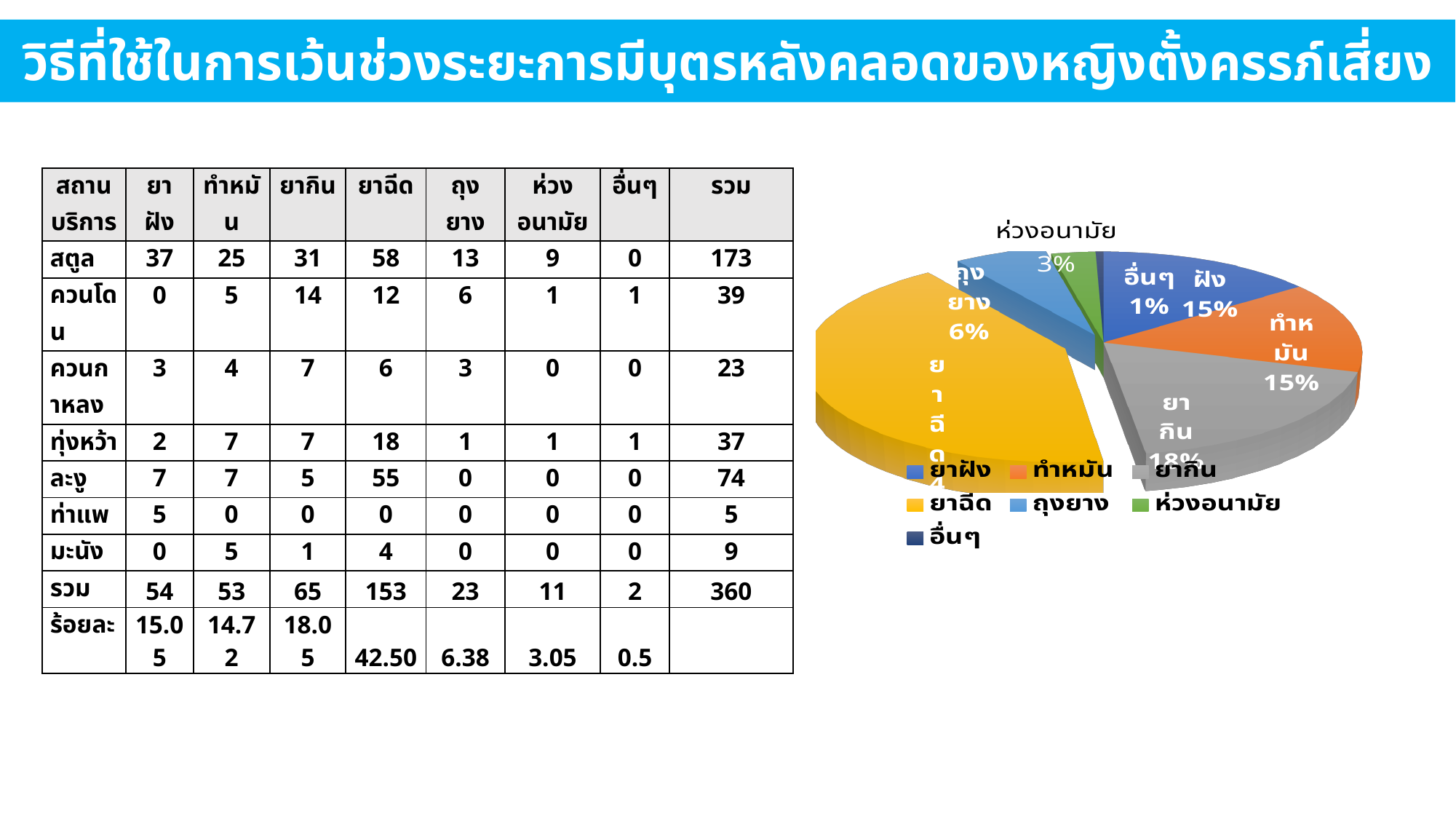
In the pie chart, what share is shown for อื่นๆ? 1% In the pie chart, which category has the largest slice? ยาฉีด In the pie chart, what colour is the ยาฉีด slice? yellow How many entries does the pie chart's legend list? 7 In the pie chart, which category has the smallest slice? อื่นๆ In the pie chart, which slice is larger, ยากิน or ยาฝัง? ยากิน In the pie chart, what is the difference in percentage points between ยากิน and ถุงยาง? 12% In the pie chart, what share is shown for ยากิน? 18% In the pie chart, what share is shown for ถุงยาง? 6% What kind of chart is shown on the right side of the slide? pie chart